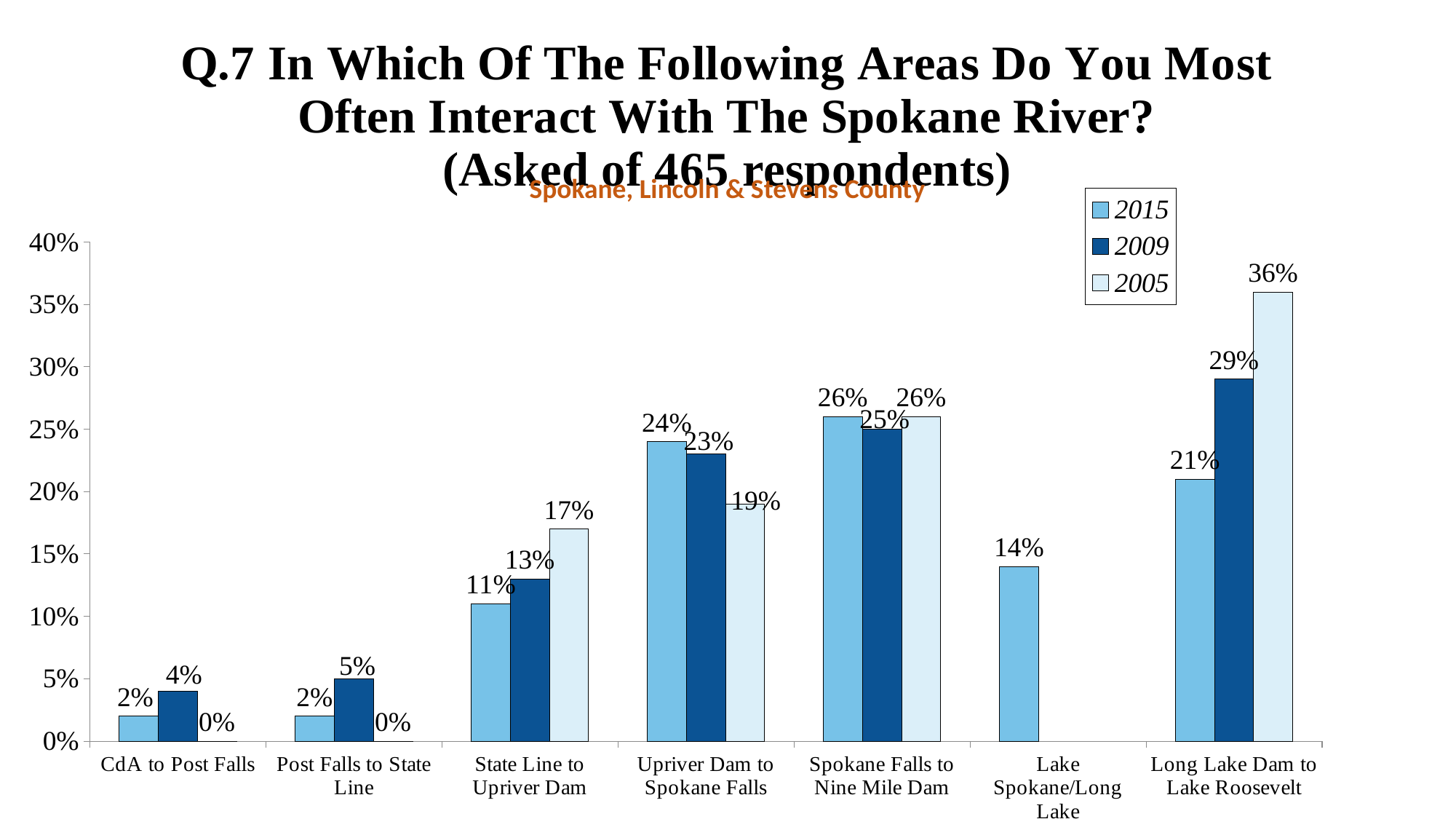
What is the 2009 value for Upriver Dam to Spokane Falls? 23% Which year does the darkest blue bar represent according to the legend? 2009 What is the 2015 value for Long Lake Dam to Lake Roosevelt? 21% What is the 2005 value for State Line to Upriver Dam? 17% Which area has the lowest 2009 value? CdA to Post Falls How many areas (categories) are shown on the x axis? 7 What kind of chart is shown on the slide? Bar chart Which area has the highest 2005 value? Long Lake Dam to Lake Roosevelt What is the 2015 value for Lake Spokane/Long Lake? 14% What is the difference between the 2005 and 2015 values for Long Lake Dam to Lake Roosevelt? 15% How many series does the legend list? 3 Which is larger for Upriver Dam to Spokane Falls: the 2015 value or the 2005 value? 2015